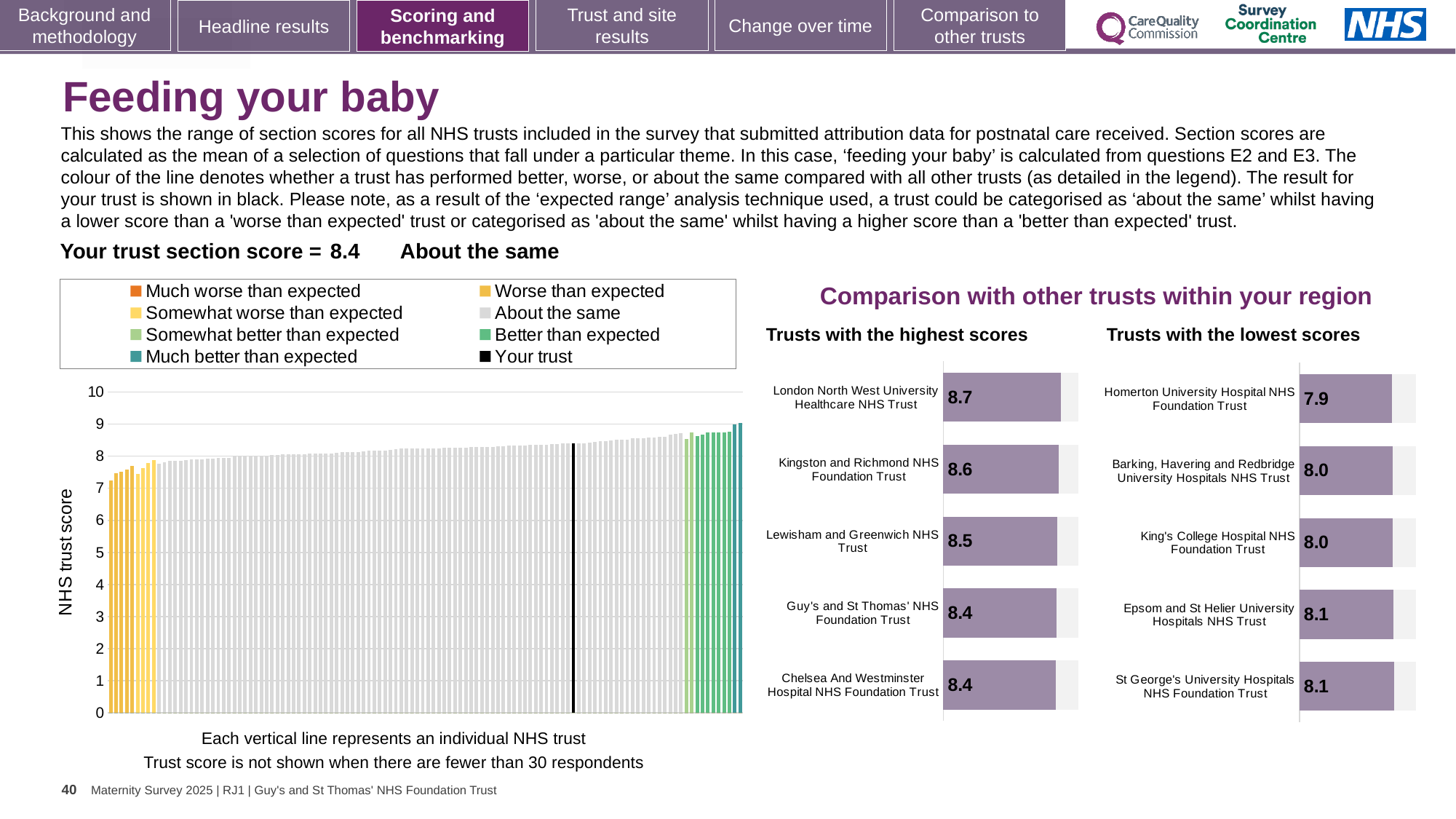
What kind of chart is the main 'NHS trust score' chart on the left? Bar chart In the main 'NHS trust score' chart, is the value of the leftmost bar greater or less than 8? less In the 'Trusts with the highest scores' chart, which trust has the highest score? London North West University Healthcare NHS Trust In the 'Trusts with the lowest scores' chart, what is the score for Homerton University Hospital NHS Foundation Trust? 7.9 Which has the larger score: Kingston and Richmond NHS Foundation Trust in the highest scores chart or Epsom and St Helier University Hospitals NHS Trust in the lowest scores chart? Kingston and Richmond NHS Foundation Trust How many trusts are shown in the 'Trusts with the highest scores' chart? 5 In the 'Trusts with the highest scores' chart, what is the difference between the scores of London North West University Healthcare NHS Trust and Lewisham and Greenwich NHS Trust? 0.2 In the 'Trusts with the lowest scores' chart, which trust has the lowest score? Homerton University Hospital NHS Foundation Trust In the 'Trusts with the highest scores' chart, what is the score for London North West University Healthcare NHS Trust? 8.7 In the main 'NHS trust score' chart, do the values rise or fall from left to right? Rise How many entries does the legend of the main 'NHS trust score' chart list? 8 What is the label on the vertical axis of the main chart on the left? NHS trust score